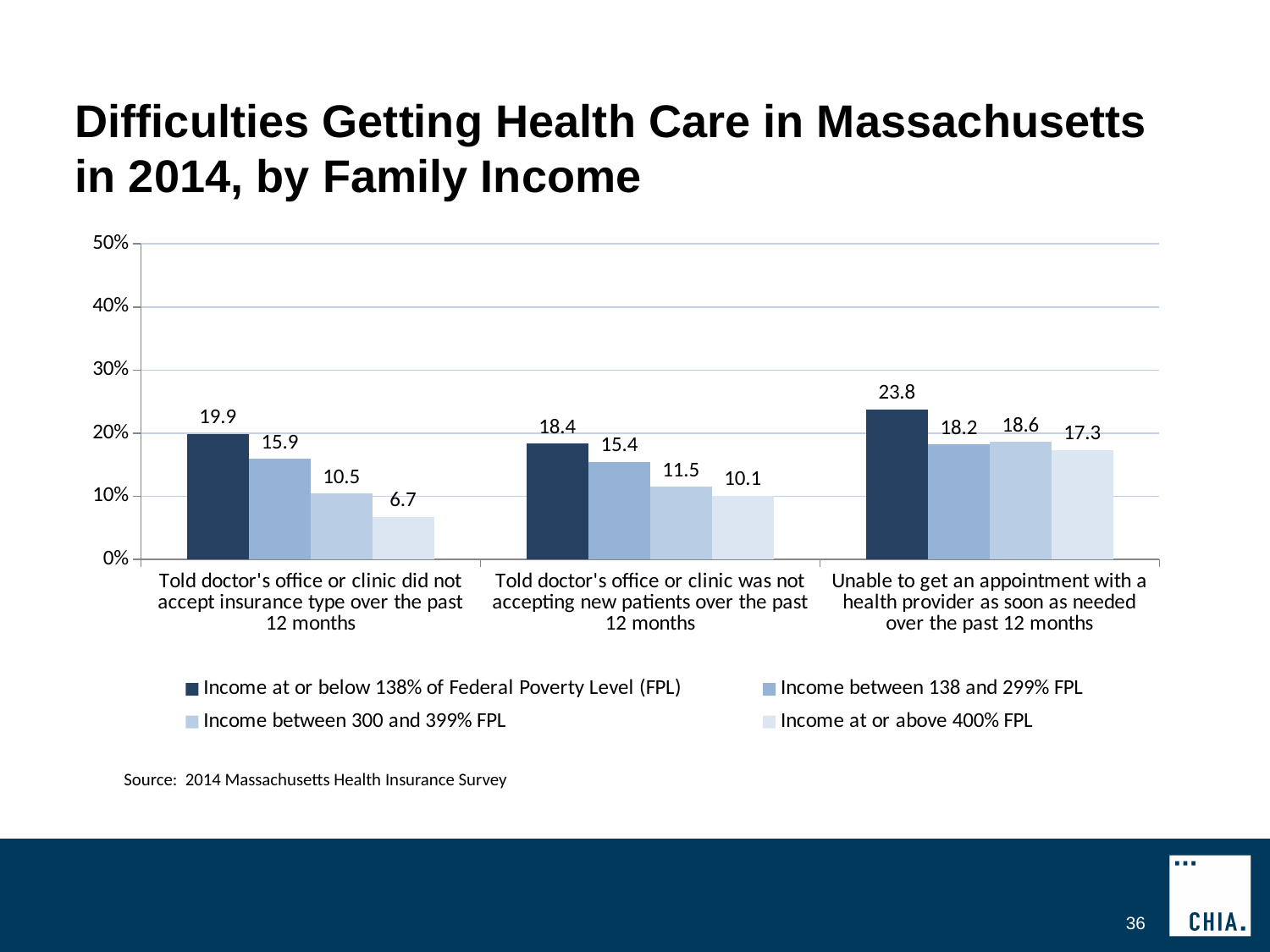
Which income group has the lowest value in the category 'Told doctor's office or clinic did not accept insurance type over the past 12 months'? Income at or above 400% FPL How many series does the legend list? 4 Is the value for 'Income at or below 138% of Federal Poverty Level (FPL)' in the category 'Unable to get an appointment with a health provider as soon as needed over the past 12 months' greater or less than 20%? greater Which is larger: the 'Income between 138 and 299% FPL' value for 'Told doctor's office or clinic did not accept insurance type' or for 'Unable to get an appointment with a health provider as soon as needed'? Unable to get an appointment with a health provider as soon as needed Which income group has the highest value in the category 'Unable to get an appointment with a health provider as soon as needed over the past 12 months'? Income at or below 138% of Federal Poverty Level (FPL) What is the value for 'Income at or above 400% FPL' in the category 'Told doctor's office or clinic was not accepting new patients over the past 12 months'? 10.1 What is the source cited below the chart? 2014 Massachusetts Health Insurance Survey What is the value for 'Income between 300 and 399% FPL' in the category 'Unable to get an appointment with a health provider as soon as needed over the past 12 months'? 18.6 What is the value for 'Income at or below 138% of Federal Poverty Level (FPL)' in the category 'Told doctor's office or clinic did not accept insurance type over the past 12 months'? 19.9 What kind of chart is shown on the slide? Bar chart How many categories are shown on the x axis of the chart? 3 What is the difference between the 'Income at or below 138% of Federal Poverty Level (FPL)' and 'Income at or above 400% FPL' values in the category 'Told doctor's office or clinic did not accept insurance type over the past 12 months'? 13.2